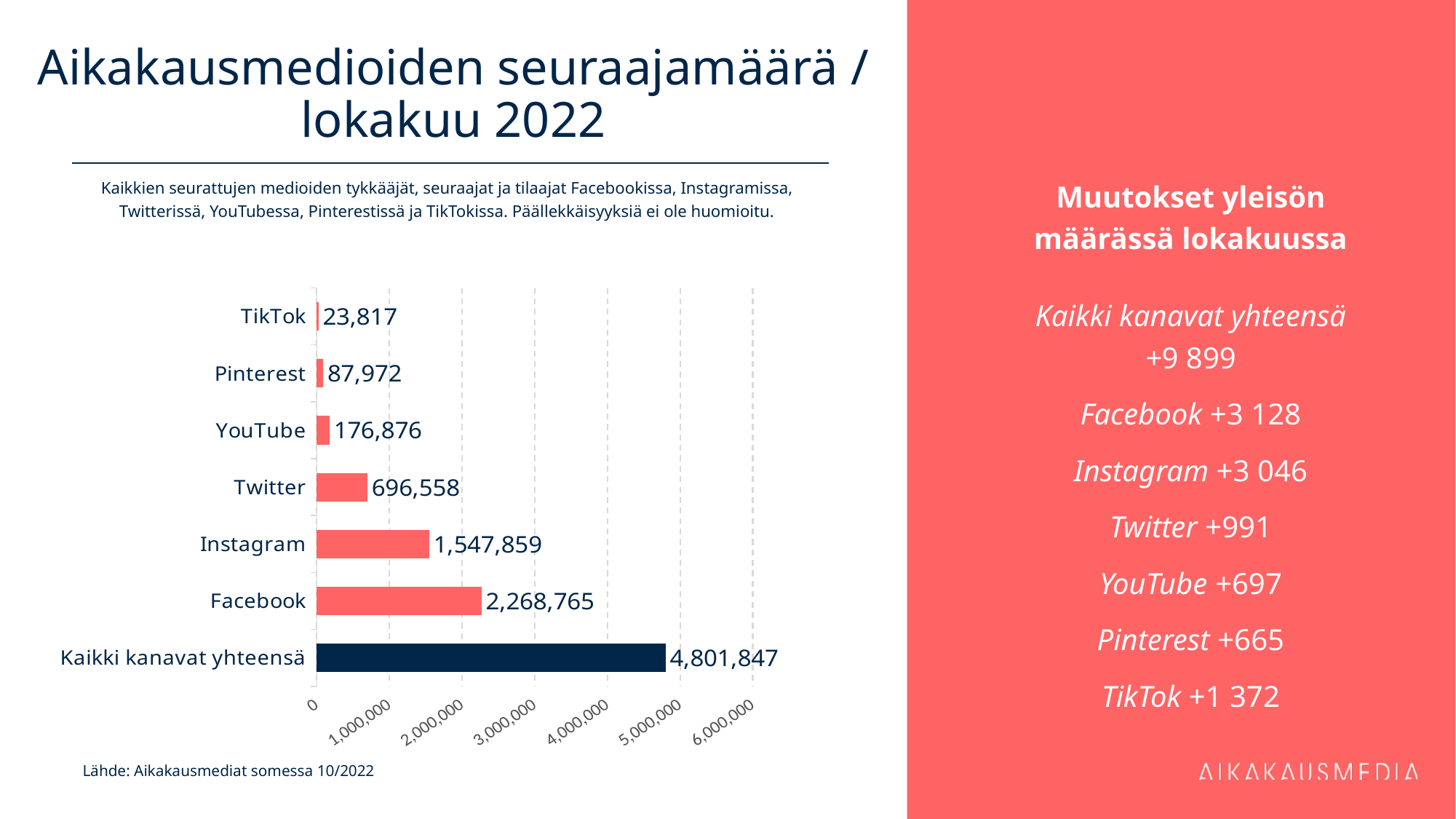
What is the value for Facebook? 2,268,765 What is the value for Instagram? 1,547,859 How many categories are plotted in the chart? 7 What type of chart is shown on the slide? bar chart What is the value for TikTok? 23,817 Which category has the highest value? Kaikki kanavat yhteensä What is the value for Kaikki kanavat yhteensä? 4,801,847 Which category has the lowest value? TikTok What is the difference between the values for Facebook and Instagram? 720,906 Is the value for Facebook greater or less than 2,000,000? greater What is the difference between the values for Twitter and YouTube? 519,682 Which has a larger value, Twitter or YouTube? Twitter